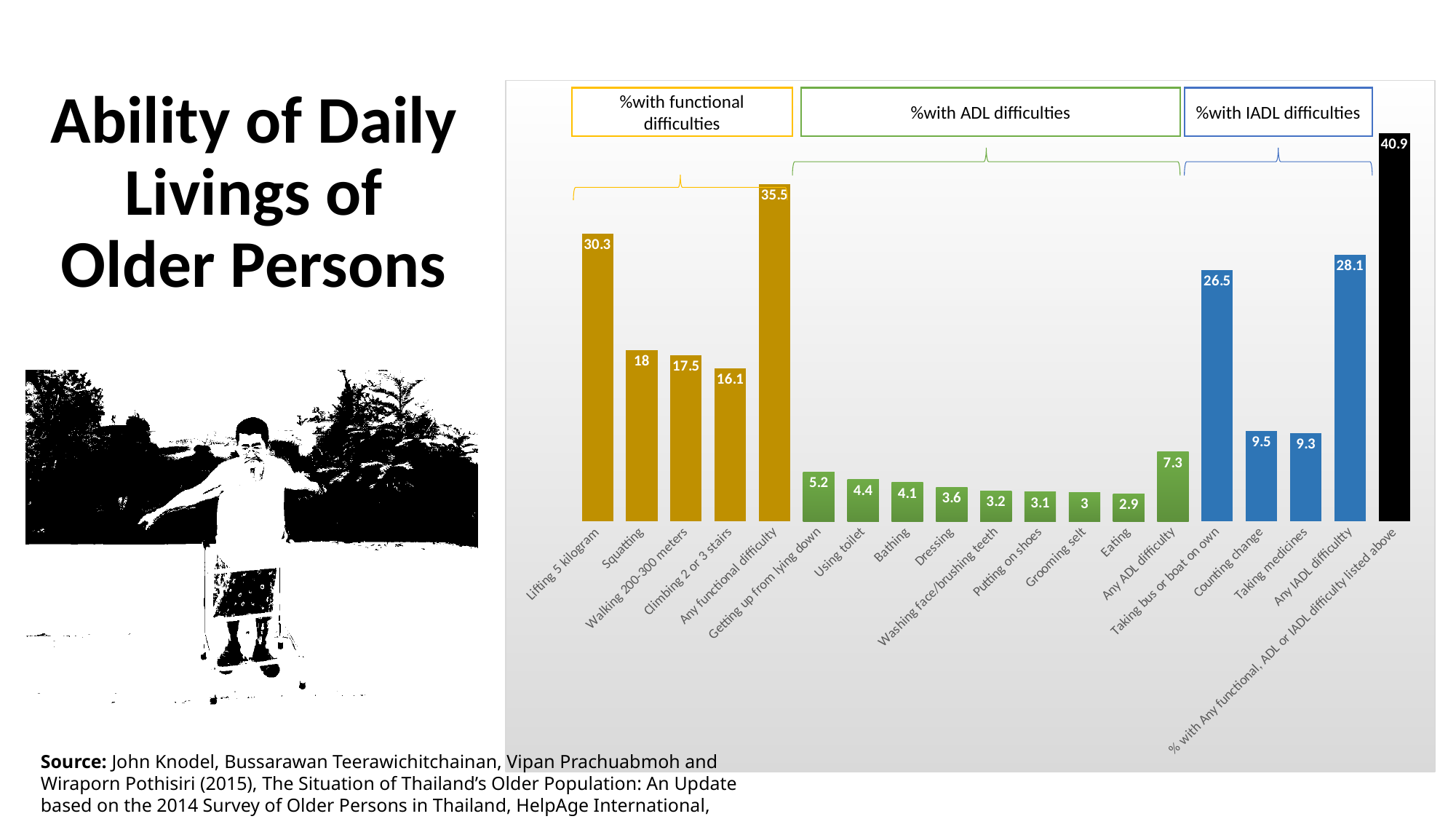
Which category has the lowest value? Eating How many bars are plotted in the chart? 19 What is the value for Lifting 5 kilogram? 30.3 What is the value for Taking bus or boat on own? 26.5 What colour are the bars in the %with ADL difficulties group? Green Which is larger, the value for Counting change or the value for Getting up from lying down? Counting change What is the difference between the values for Any functional difficulty and Any ADL difficulty? 28.2 What is the value for Eating? 2.9 What is the value for Any IADL difficulty? 28.1 What kind of chart is shown on the slide? Bar chart Which category has the highest value? % with Any functional, ADL or IADL difficulty listed above What is the difference between the values for Squatting and Walking 200-300 meters? 0.5